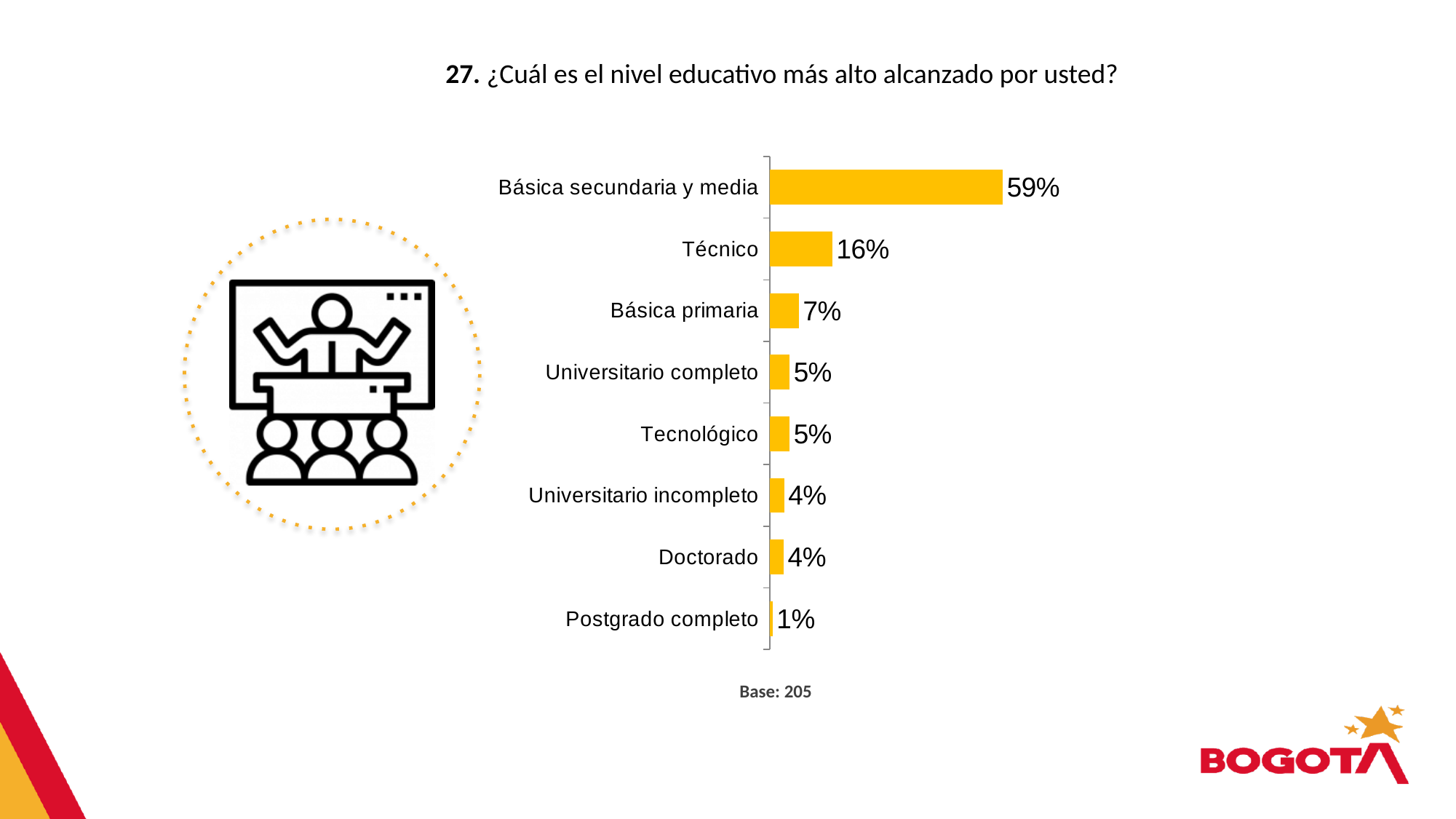
What kind of chart is shown on the slide? Bar chart What is the value for Técnico? 16% Which category has the lowest value? Postgrado completo What is the value for Básica primaria? 7% What is the value for Básica secundaria y media? 59% Which category has the highest value? Básica secundaria y media What is the base (number of respondents) shown below the chart? 205 How many categories are shown in the chart? 8 Which is larger, the value for Técnico or the value for Básica primaria? Técnico What colour are the bars in the chart? Yellow What is the value for Postgrado completo? 1% What is the difference between the values for Básica secundaria y media and Técnico? 43%